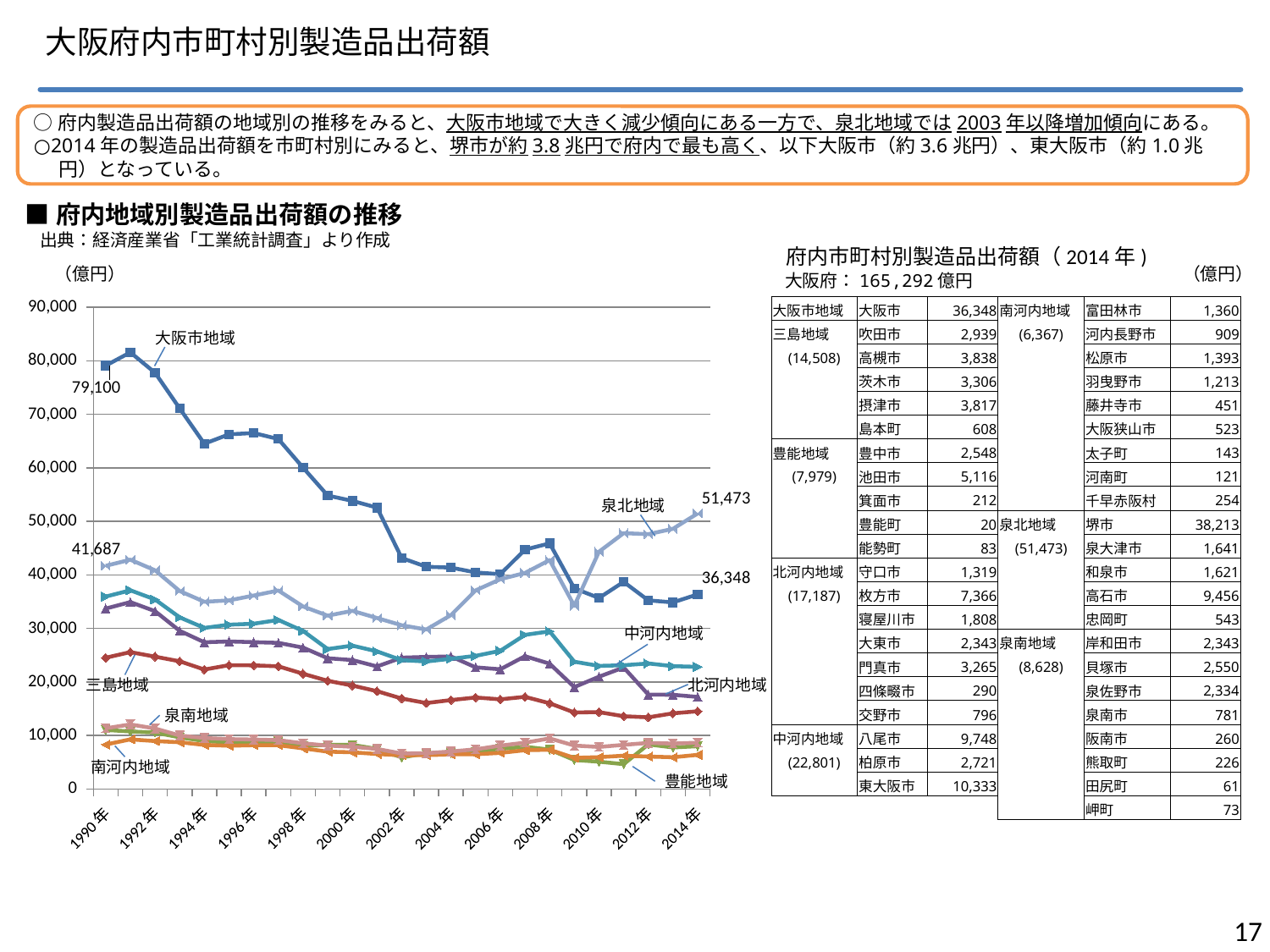
In the line chart, which is larger in 2014年: 泉北地域 or 大阪市地域? 泉北地域 In the line chart, what is the difference between 泉北地域 in 2014年 (51,473) and 大阪市地域 in 2014年 (36,348)? 15,125 What kind of chart is shown on the left of the slide? line chart In the line chart, which region has the highest value in 1990年? 大阪市地域 In the line chart, what is the labelled value for 大阪市地域 in 2014年? 36,348 In the line chart, is the value for 三島地域 in 1990年 greater or less than 30,000? less In the line chart, what is the labelled value for 泉北地域 in 2014年? 51,473 In the line chart, what is the labelled value for 泉北地域 in 1990年? 41,687 In the line chart, is the value for 豊能地域 in 2014年 greater or less than 10,000? less In the line chart, does the value for 大阪市地域 generally rise or fall from 1990年 to 2014年? fall In the line chart, by how much did the value for 大阪市地域 fall from 1990年 (79,100) to 2014年 (36,348)? 42,752 In the line chart, what is the labelled value for 大阪市地域 in 1990年? 79,100